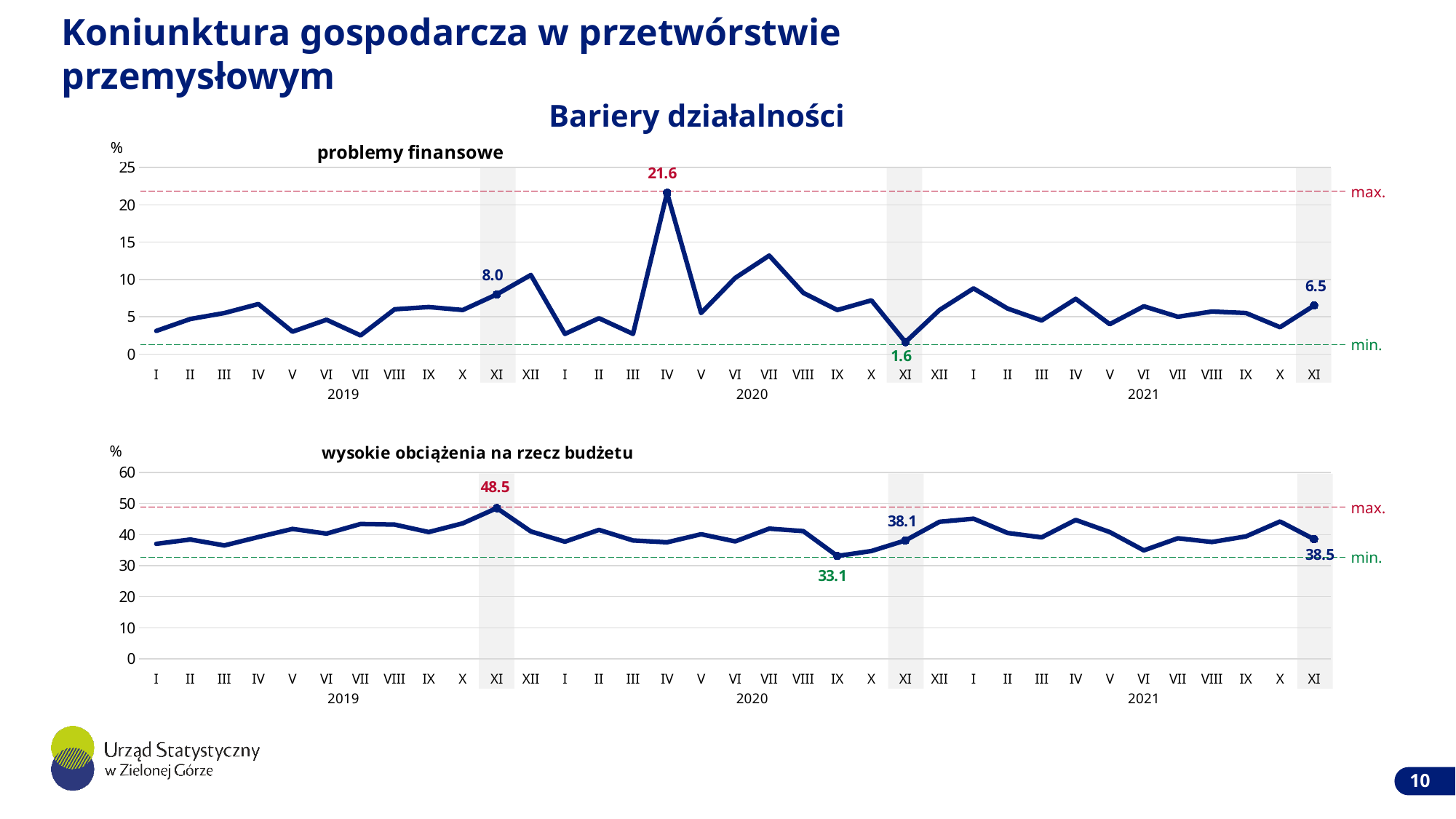
In the 'wysokie obciążenia na rzecz budżetu' chart, what is the value for XI 2019? 48.5 In the 'wysokie obciążenia na rzecz budżetu' chart, what is the difference between the maximum value and the minimum value? 15.4 In the 'problemy finansowe' chart, which month has the highest value? IV 2020 What is the main title above the two charts? Bariery działalności In the 'problemy finansowe' chart, what is the difference between the value for XI 2019 and the value for XI 2021? 1.5 In the 'problemy finansowe' chart, what is the value for IV 2020? 21.6 In the 'wysokie obciążenia na rzecz budżetu' chart, which month has the lowest value? IX 2020 In the 'problemy finansowe' chart, what is the value for XI 2021? 6.5 What kind of chart is the 'problemy finansowe' chart? line chart In the 'problemy finansowe' chart, what is the value for XI 2020? 1.6 In the 'problemy finansowe' chart, is the value for VII 2020 greater or less than 10? greater In the 'wysokie obciążenia na rzecz budżetu' chart, which is larger: the value for XI 2020 or the value for XI 2021? XI 2021